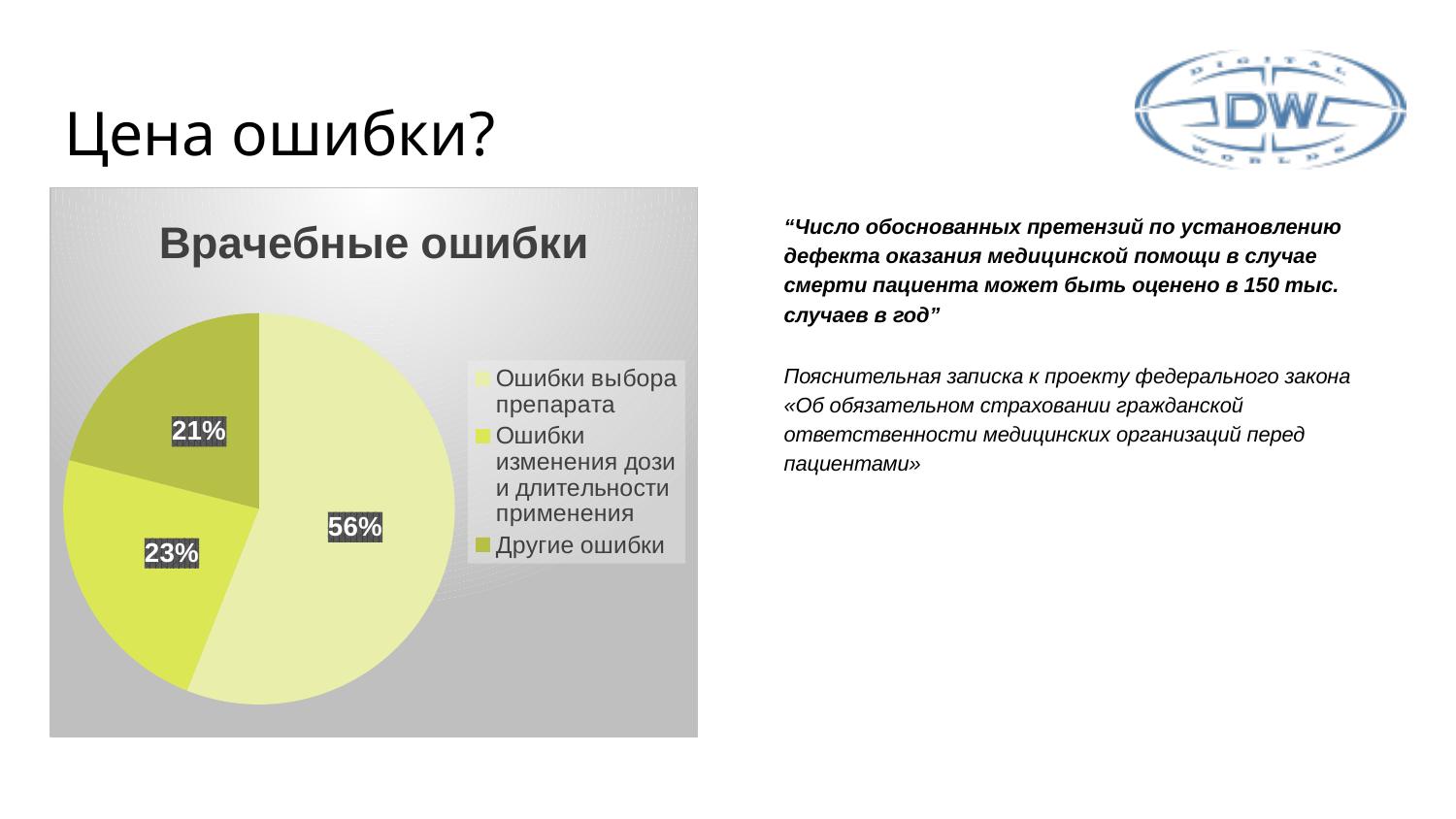
What type of chart is shown on the slide? pie chart How many slices does the pie chart have? 3 Which category has the smallest slice of the pie? Другие ошибки What is the combined share of "Ошибки изменения дозы и длительности применения" and "Другие ошибки"? 44% How many entries does the legend list? 3 What is the title of the chart? Врачебные ошибки What share of the pie is labelled "Ошибки выбора препарата"? 56% What share of the pie is labelled "Другие ошибки"? 21% Which category has the largest slice of the pie? Ошибки выбора препарата What is the difference between the share for "Ошибки выбора препарата" and the share for "Другие ошибки"? 35% Which is larger: the share for "Ошибки изменения дозы и длительности применения" or the share for "Другие ошибки"? Ошибки изменения дозы и длительности применения What share of the pie is labelled "Ошибки изменения дозы и длительности применения"? 23%